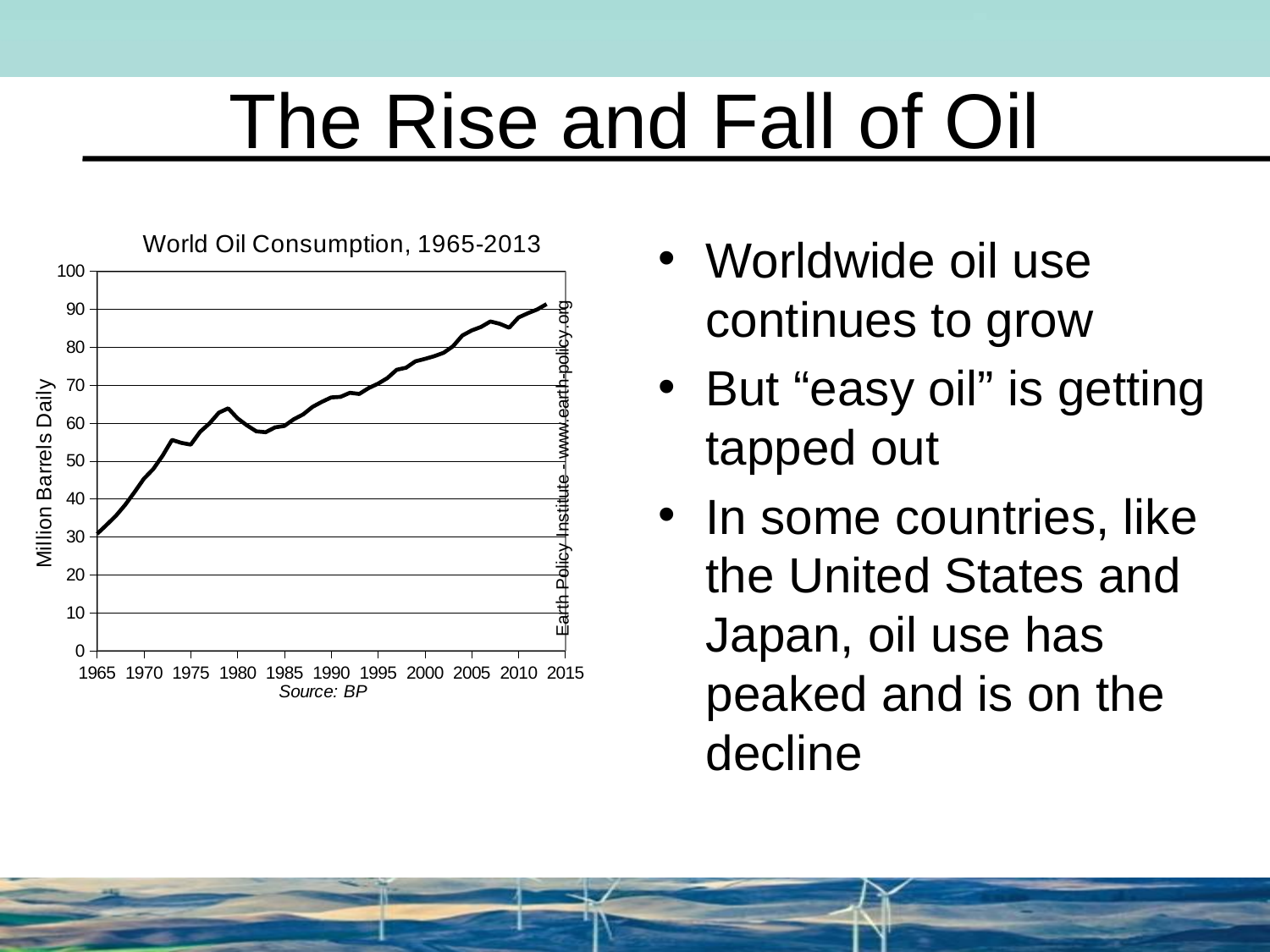
Is the value for 1965 greater or less than 40? less Is the value for 1970 greater or less than 50? less Overall, do the values in the chart rise or fall from 1965 to 2013? rise Is the value for 2005 greater or less than 80? greater What is the title of the chart? World Oil Consumption, 1965-2013 Which year has the higher value, 1965 or 2013? 2013 What kind of chart is shown on the slide? line chart What is the label on the vertical axis of the chart? Million Barrels Daily Which year has the higher value, 1980 or 1985? 1980